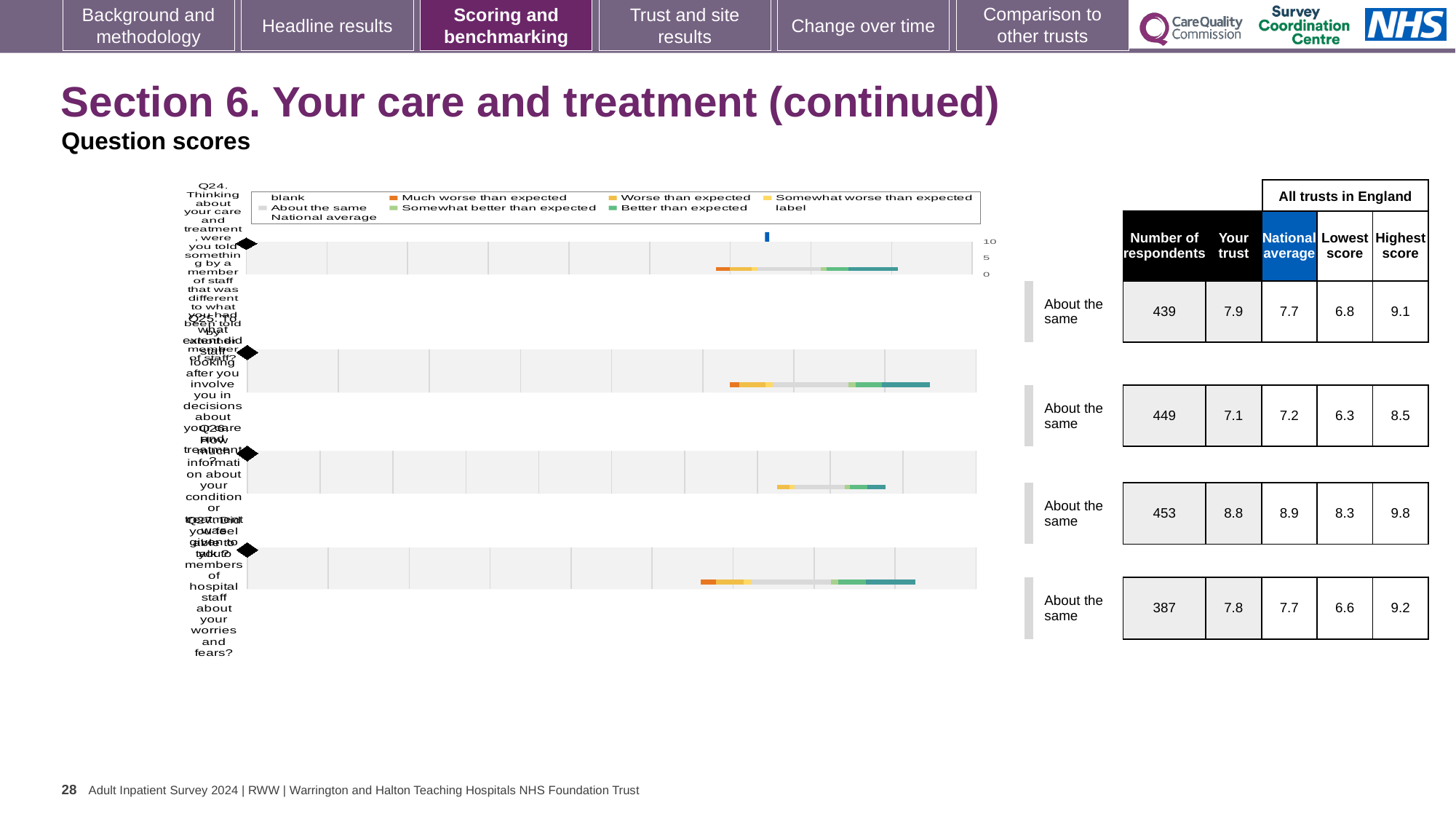
What benchmark category label is shown beside the Q24 chart? About the same Which legend entry is shown in orange-red in the chart legend? Much worse than expected What is the highest tick value shown on the axis above the Q24 chart? 10 In the table beside the Q27 chart, what is the highest score among all trusts in England? 9.2 In the table beside the Q26 chart, what is the number of respondents? 453 How many question charts (Q24 to Q27) are shown on the slide? 4 In the table beside the Q24 chart, what is the 'Your trust' score? 7.9 What kind of chart is used to show the question scores on this slide? bar chart In the table beside the Q25 chart, is the 'Your trust' score or the national average larger? National average What benchmark category label is shown beside the Q27 chart? About the same